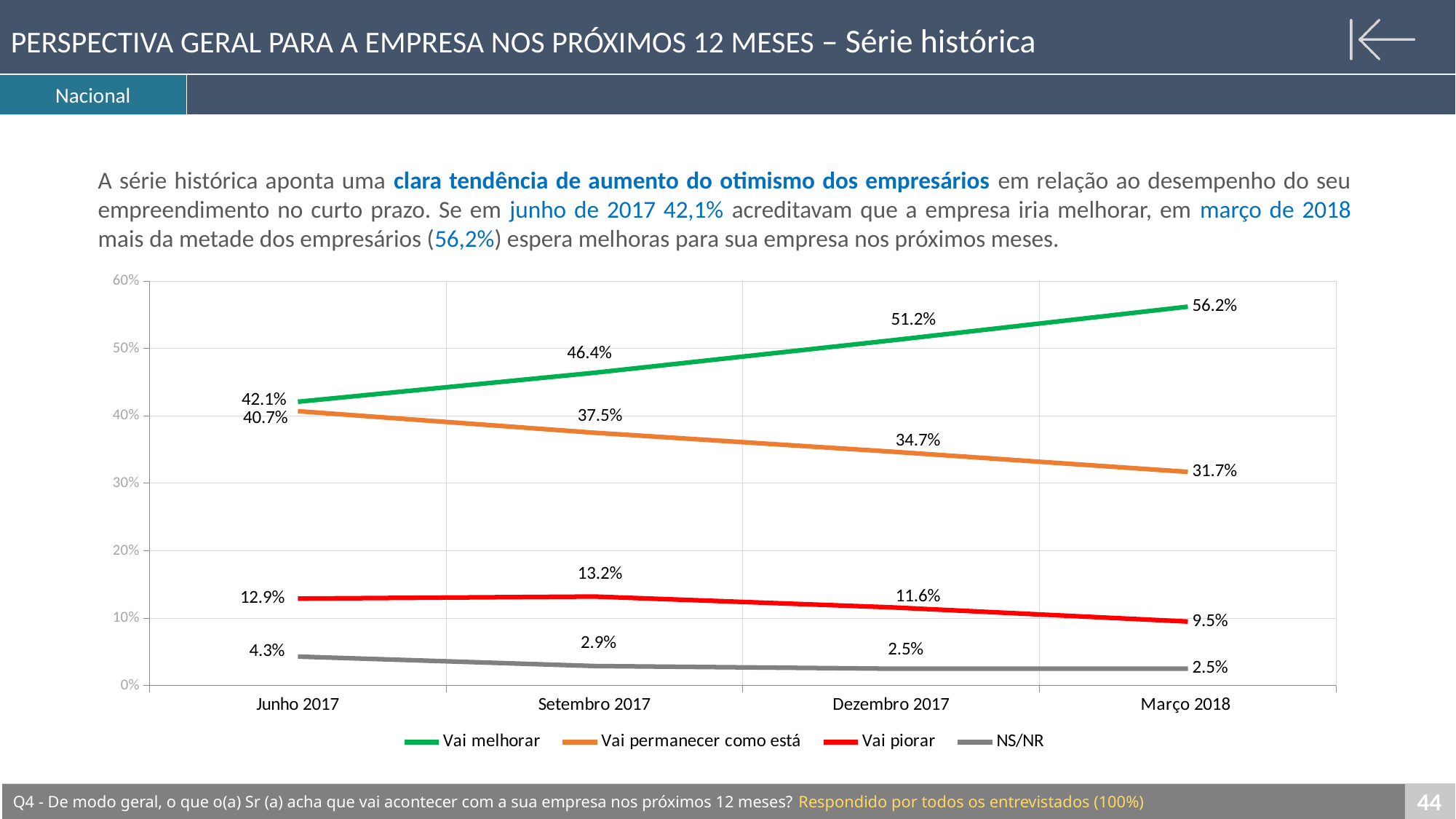
What is the difference between the "Vai melhorar" values in Março 2018 and Junho 2017? 14.1% What kind of chart is shown on the slide? Line chart Which is larger in Junho 2017: "Vai melhorar" or "Vai permanecer como está"? Vai melhorar What is the value for "Vai permanecer como está" in Setembro 2017? 37.5% How many periods are shown on the x axis? 4 In which period is the value for "Vai piorar" lowest? Março 2018 How many series does the legend list? 4 What is the value for "Vai melhorar" in Março 2018? 56.2% What is the value for "Vai piorar" in Dezembro 2017? 11.6% In which period is the value for "Vai melhorar" highest? Março 2018 What is the value for "NS/NR" in Junho 2017? 4.3% Does the "Vai permanecer como está" series rise or fall from Junho 2017 to Março 2018? Fall